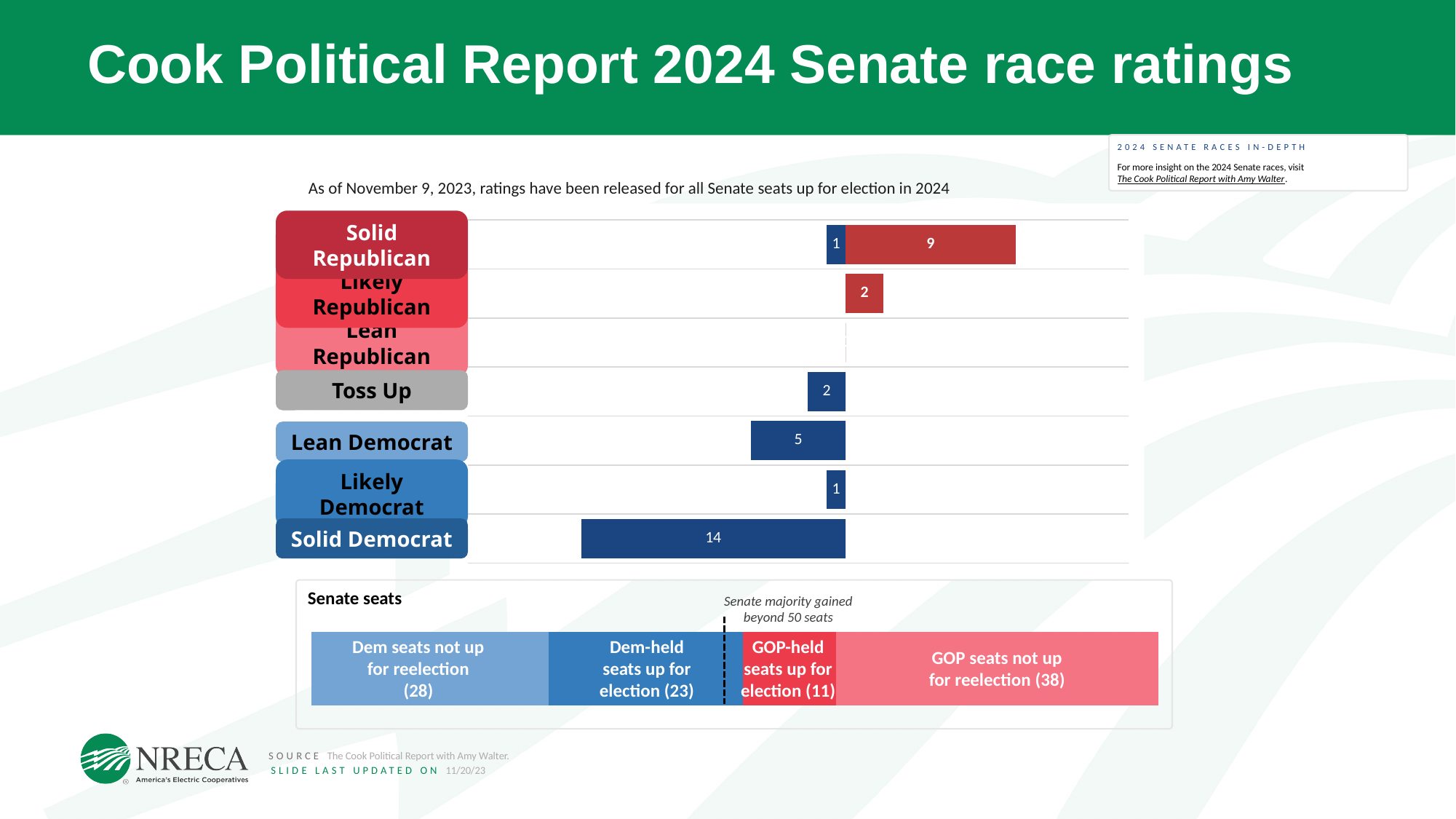
How many seats are rated Toss Up? 2 How many seats are rated Likely Democrat? 1 In the Solid Republican row, what value is shown on the red segment? 9 Which has more seats, Lean Democrat or Likely Republican? Lean Democrat How many more seats are rated Solid Democrat than Lean Democrat? 9 What is the total number of seats in the Solid Republican row, adding both segments? 10 What kind of chart is used to show the race ratings? Bar chart How many seats are rated Lean Democrat? 5 How many seats are rated Likely Republican? 2 In the Senate seats bar at the bottom, how many GOP seats are not up for reelection? 38 How many Senate seats are rated Solid Democrat? 14 Which rating category has the most seats? Solid Democrat